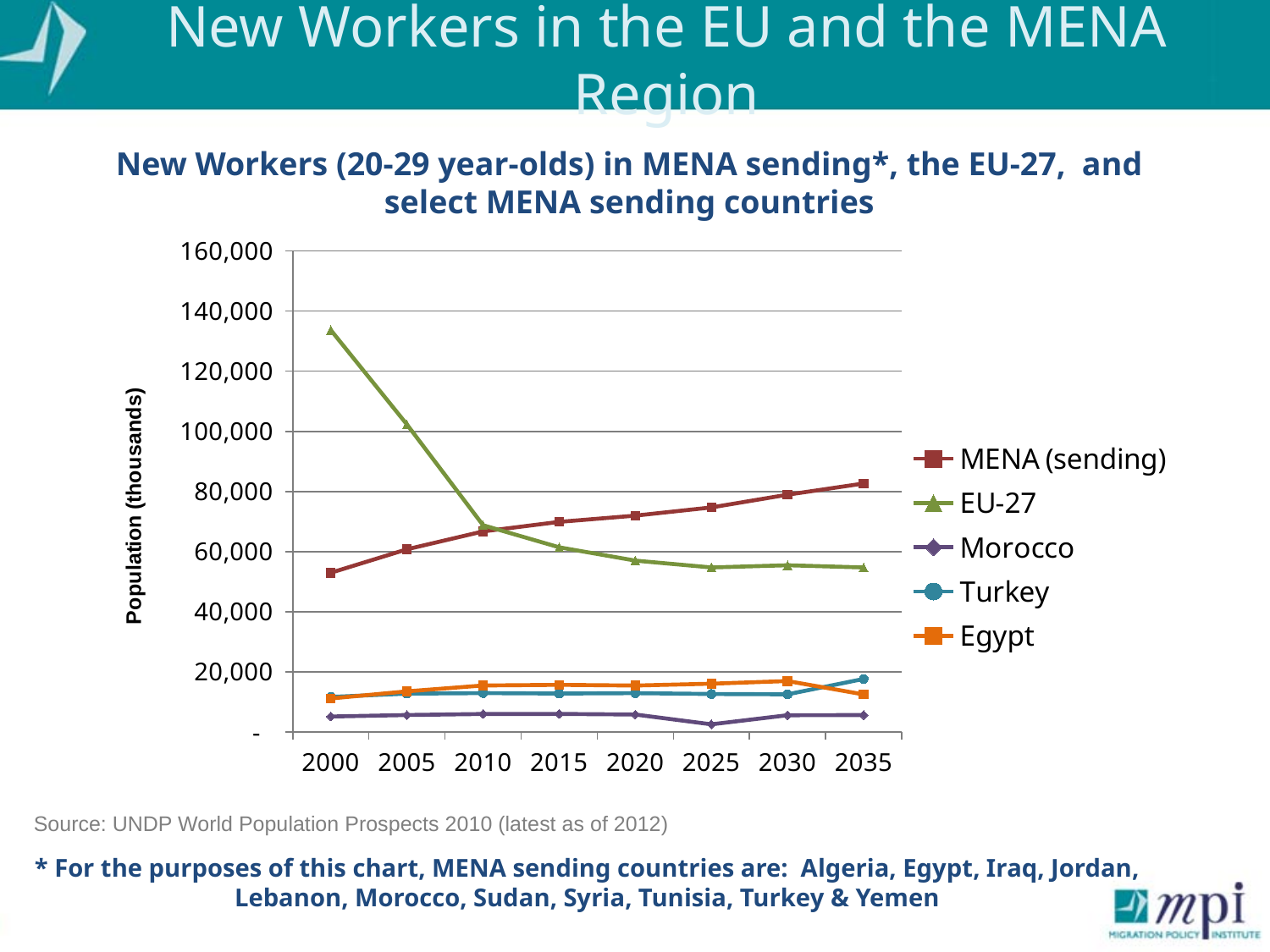
In 2000, which is larger: EU-27 or MENA (sending)? EU-27 Does the EU-27 line rise or fall from 2000 to 2035? fall Is the value for EU-27 in 2000 greater or less than 120,000? greater In 2035, which is larger: MENA (sending) or EU-27? MENA (sending) Is the value for MENA (sending) in 2000 greater or less than 60,000? less How many years are shown along the x axis? 8 Does the MENA (sending) line rise or fall from 2000 to 2035? rise Which series has the lowest value in 2035? Morocco How many series does the legend list? 5 Is the value for Egypt in 2035 greater or less than 20,000? less What kind of chart is shown on the slide? line chart What is the label on the y axis? Population (thousands)